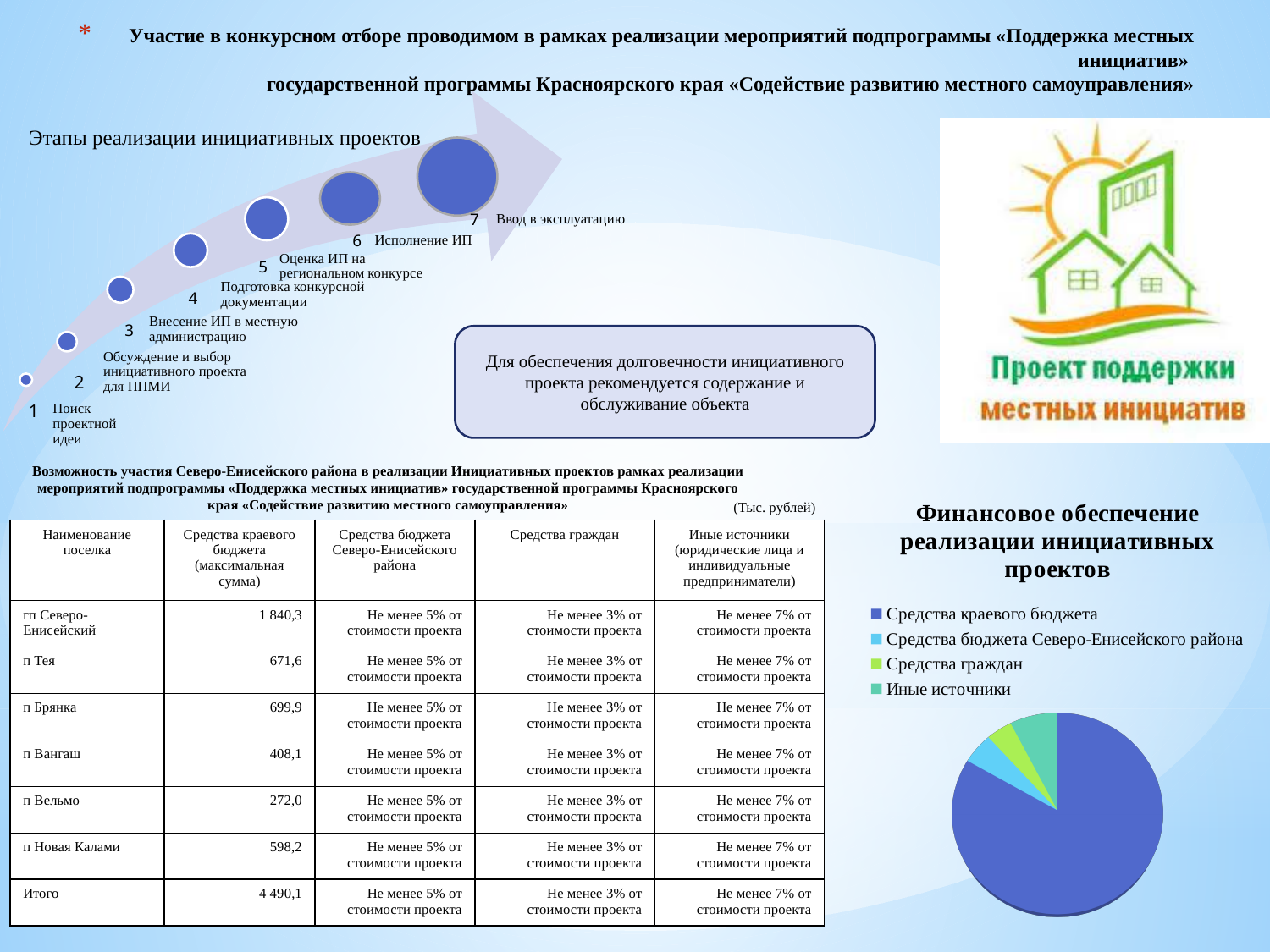
Which slice is larger in the pie chart: Средства краевого бюджета or Средства граждан? Средства краевого бюджета Which slice is larger in the pie chart: Средства краевого бюджета or Иные источники? Средства краевого бюджета What kind of chart is shown on the slide? Pie chart How many slices does the pie chart have? 4 What is the title of the pie chart? Финансовое обеспечение реализации инициативных проектов Which category has the largest slice in the pie chart? Средства краевого бюджета How many entries does the legend of the pie chart list? 4 Which colour represents Средства граждан in the pie chart? Light green